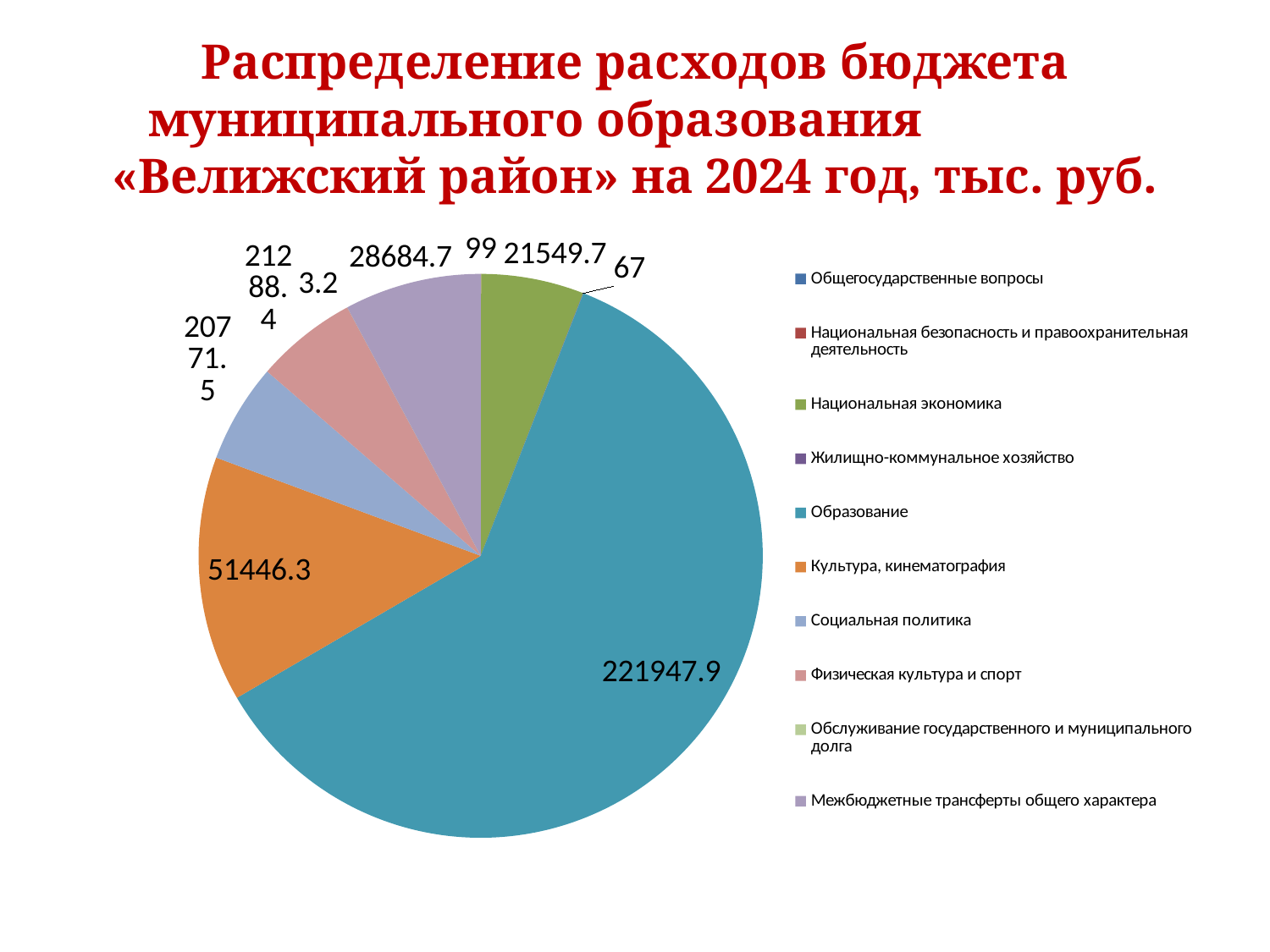
What is the value for Межбюджетные трансферты общего характера? 28684.7 What is the value for Культура, кинематография? 51446.3 What is the value for Образование? 221947.9 Which is larger: Культура, кинематография or Межбюджетные трансферты общего характера? Культура, кинематография What is the value for Национальная экономика? 21549.7 What type of chart is shown on the slide? pie chart What is the value for Социальная политика? 20771.5 Which category has the largest slice of the pie? Образование What colour is the slice for Образование? teal How many categories does the legend list? 10 What is the difference between the values for Образование and Культура, кинематография? 170501.6 What is the value for Физическая культура и спорт? 21288.4